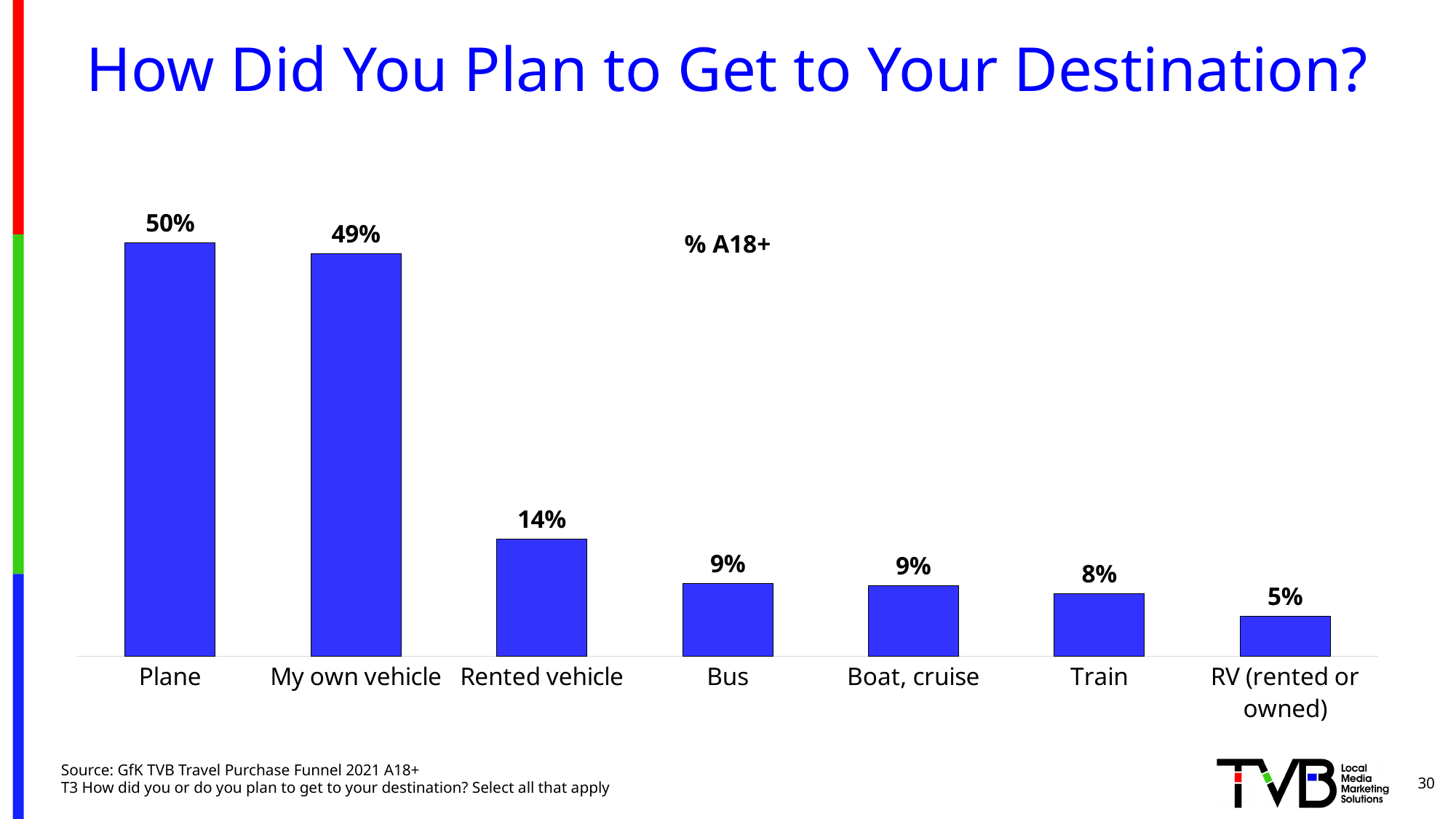
What is the title of the chart on the slide? How Did You Plan to Get to Your Destination? What kind of chart is shown on the slide? Bar chart What is the value shown for 'Train'? 8% Which is larger, the value for 'Train' or the value for 'RV (rented or owned)'? Train What is the difference between the values for 'Rented vehicle' and 'Bus'? 5% What percentage of respondents planned to get to their destination by plane? 50% What is the difference between the values for 'Plane' and 'My own vehicle'? 1% What is the value shown for 'Rented vehicle'? 14% Which mode of transportation has the lowest value on the chart? RV (rented or owned) How many categories are shown on the chart? 7 Which category has the highest value on the chart? Plane Do the values rise or fall moving from left to right across the categories? Fall